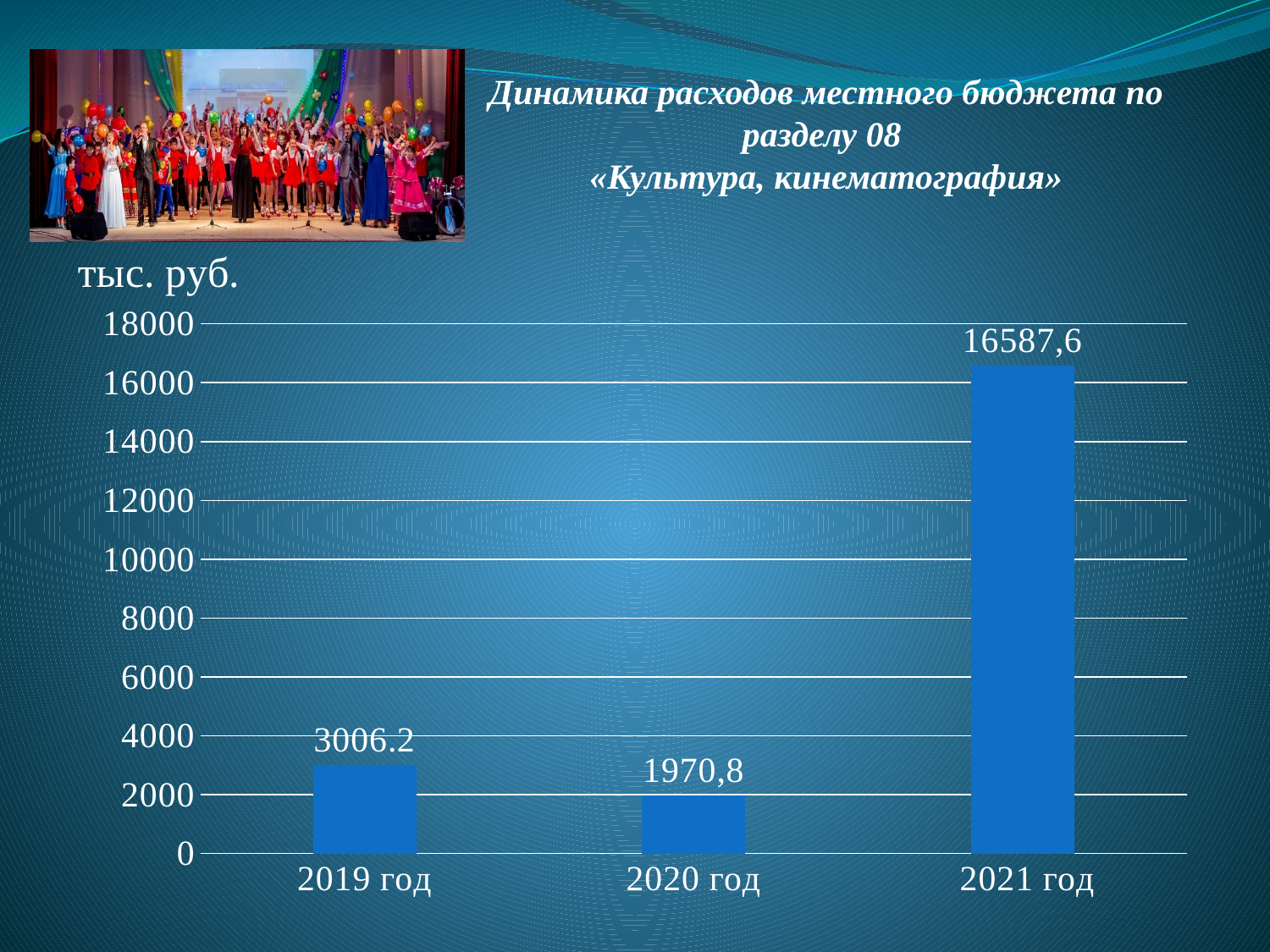
What is the value for 2020 год? 1970,8 What is the difference between the values for 2019 год and 2020 год? 1035,4 What is the value for 2021 год? 16587,6 What is the value for 2019 год? 3006.2 How many years are shown on the chart? 3 Which is larger, the value for 2019 год or the value for 2020 год? 2019 год Which year has the lowest value? 2020 год What is the difference between the values for 2021 год and 2019 год? 13581,4 Which year has the highest value? 2021 год What unit is shown above the vertical axis of the chart? тыс. руб. Is the value for 2021 год greater or less than 16000? greater What kind of chart is shown on the slide? bar chart